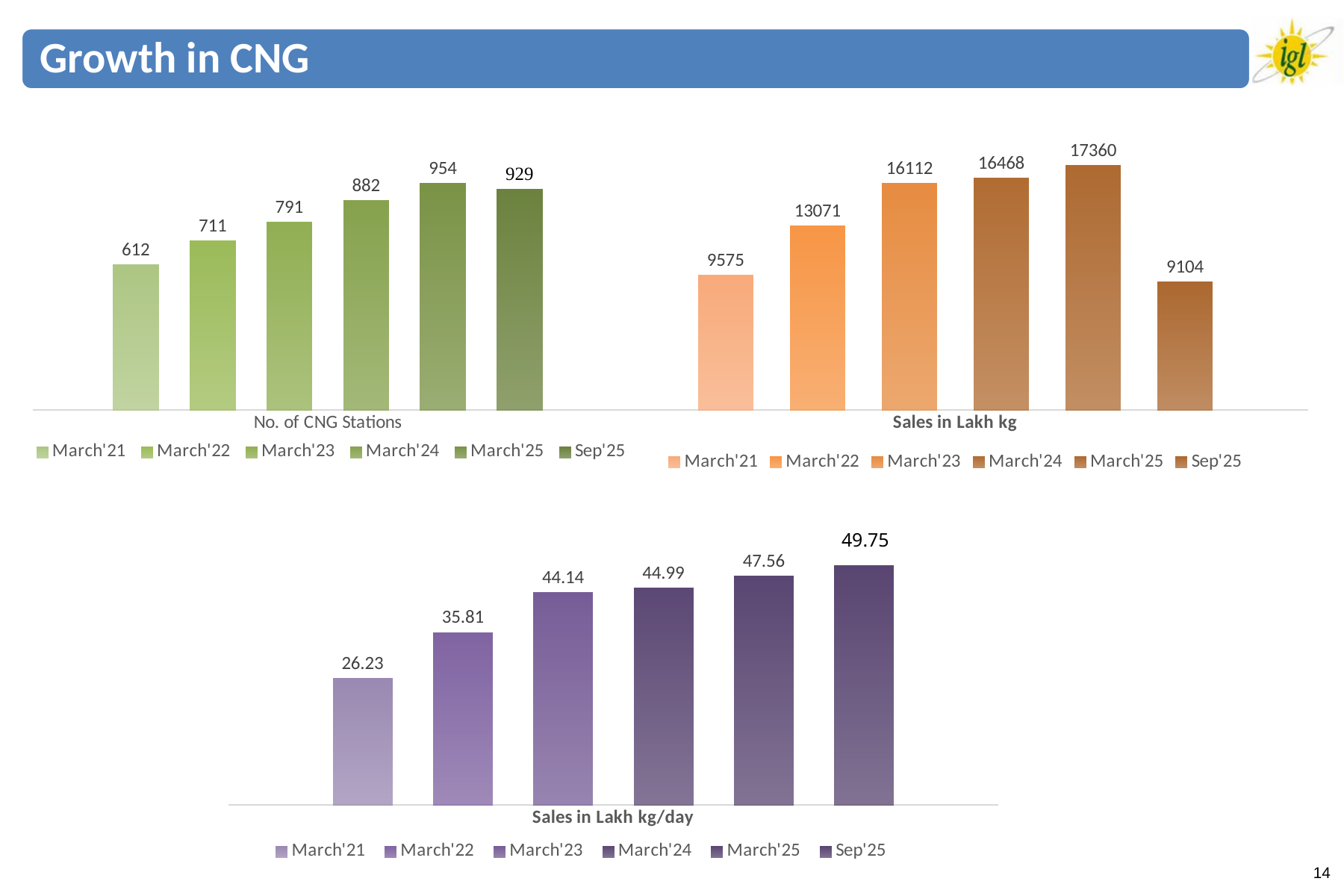
In the 'Sales in Lakh kg/day' chart, which period has the highest value? Sep'25 In the 'Sales in Lakh kg/day' chart, what is the value for March'22? 35.81 In the 'Sales in Lakh kg/day' chart, do the values rise or fall from March'21 to Sep'25? Rise In the 'Sales in Lakh kg' chart, which period has the lowest value? Sep'25 In the 'No. of CNG Stations' chart, what is the value for March'25? 954 How many series does the legend of the 'Sales in Lakh kg/day' chart list? 6 What kind of chart is the 'No. of CNG Stations' chart? Bar chart In the 'Sales in Lakh kg' chart, what is the value for March'24? 16468 In the 'No. of CNG Stations' chart, what is the difference between the March'25 and March'21 values? 342 In the 'Sales in Lakh kg' chart, which period has the highest value? March'25 In the 'Sales in Lakh kg' chart, which is larger: the value for March'22 or the value for Sep'25? March'22 In the 'No. of CNG Stations' chart, what is the value for Sep'25? 929